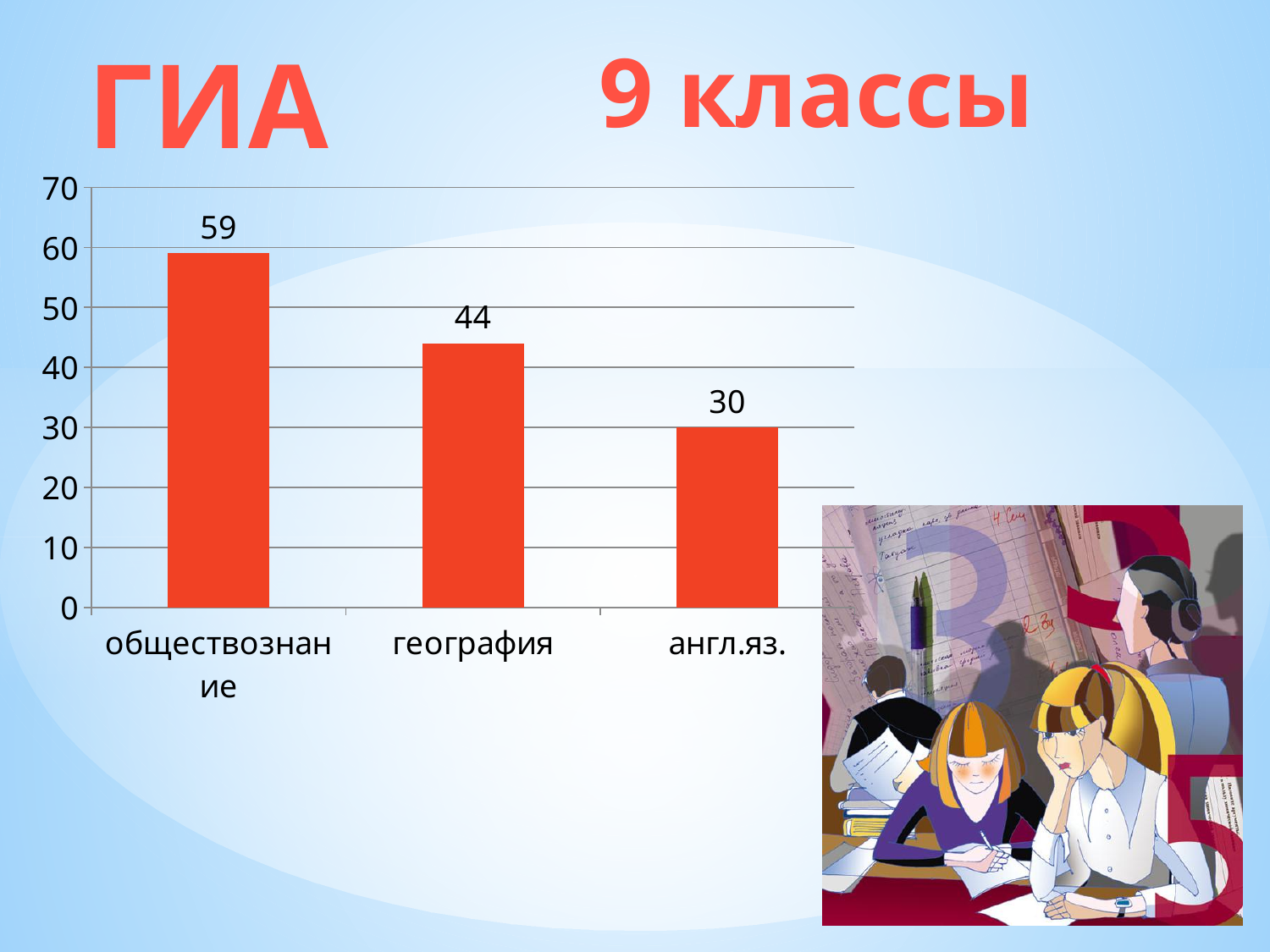
How many categories are shown on the chart? 3 What is the value for англ.яз.? 30 Which category has the highest value? обществознание What is the difference between the values for география and англ.яз.? 14 What is the value for обществознание? 59 What kind of chart is shown on the slide? bar chart Which is larger, the value for география or the value for англ.яз.? география Which category has the lowest value? англ.яз. What is the value for география? 44 Do the values rise or fall from left to right along the x axis? fall Is the value for обществознание greater or less than 50? greater What is the difference between the values for обществознание and география? 15